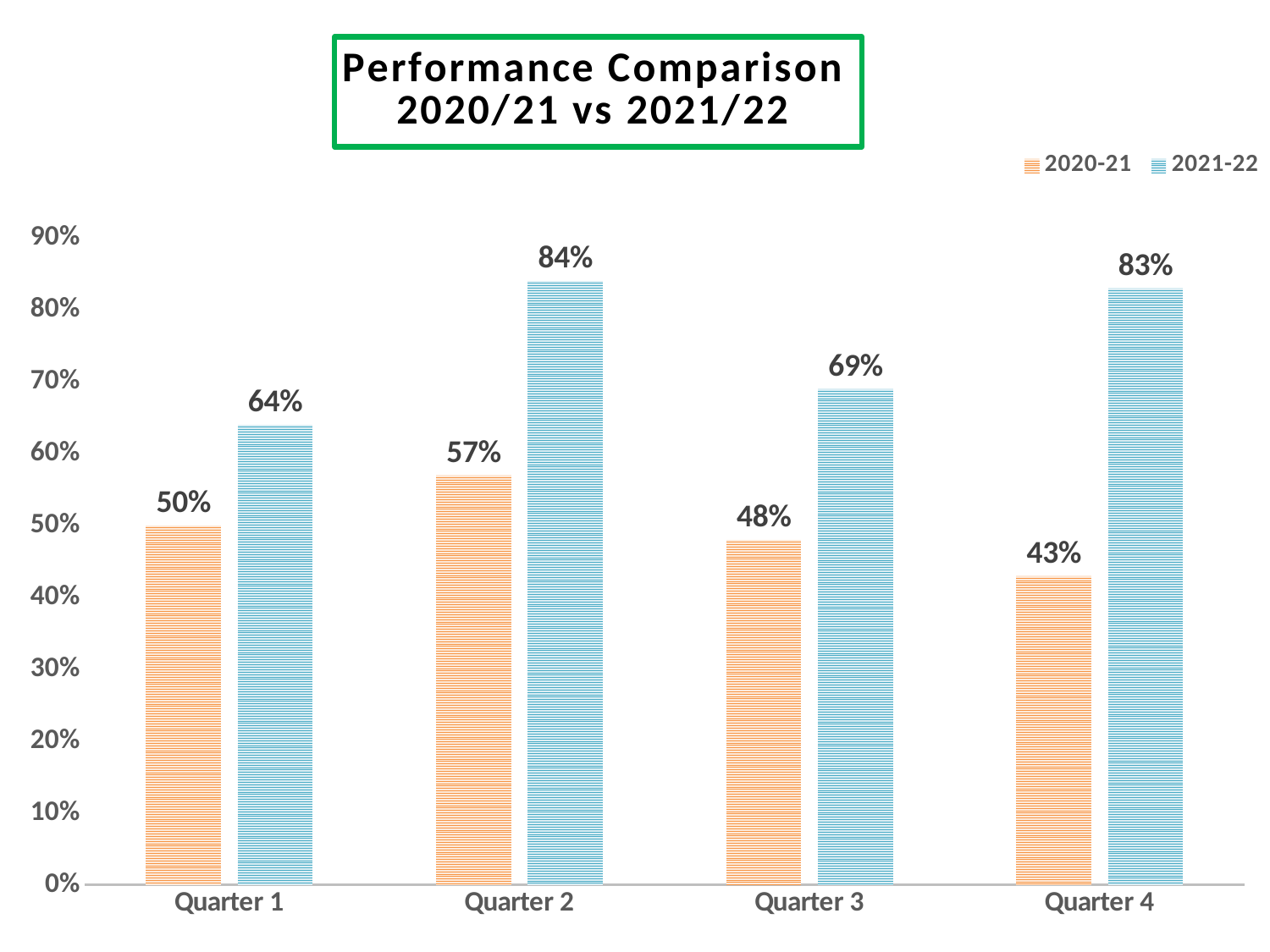
Which quarter has the lowest value for 2020-21? Quarter 4 Is the value for 2020-21 in Quarter 2 greater or less than 50%? greater What kind of chart is shown on the slide? Bar chart What is the difference between the 2021-22 and 2020-21 values in Quarter 4? 40% What is the value for 2021-22 in Quarter 2? 84% How many series does the legend list? 2 What is the value for 2020-21 in Quarter 3? 48% Which is larger in Quarter 3: the 2020-21 value or the 2021-22 value? 2021-22 What is the value for 2020-21 in Quarter 4? 43% Which quarter has the highest value for 2021-22? Quarter 2 How many quarters are shown on the x axis? 4 What is the difference between the 2021-22 and 2020-21 values in Quarter 1? 14%